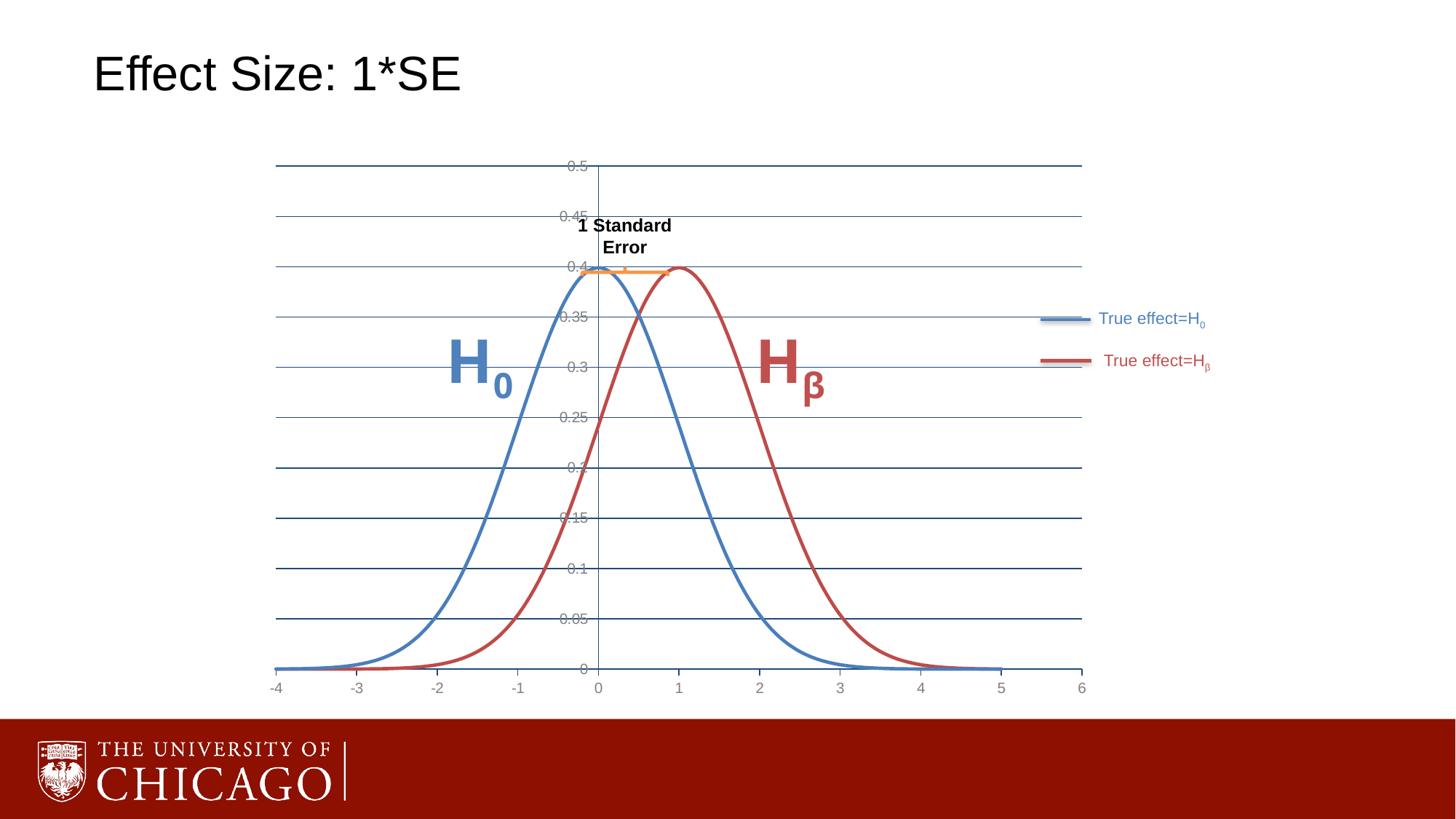
Is the peak value of the blue True effect=H0 curve greater or less than 0.35? greater What are the two series named in the legend? True effect=H0 and True effect=Hβ How many series does the legend list? 2 At which x-axis value does the blue True effect=H0 curve reach its peak? 0 At x = -1, which curve has the higher value, True effect=H0 or True effect=Hβ? True effect=H0 What is the title of the slide containing the chart? Effect Size: 1*SE Does the blue True effect=H0 curve rise or fall as x increases from 0 to 4? fall At x = 2, which curve has the higher value, True effect=H0 or True effect=Hβ? True effect=Hβ What kind of chart is shown on the slide? line chart Does the red True effect=Hβ curve rise or fall as x increases from -3 to 1? rise At which x-axis value does the red True effect=Hβ curve reach its peak? 1 Is the value of the red True effect=Hβ curve at x = 3 greater or less than 0.1? less